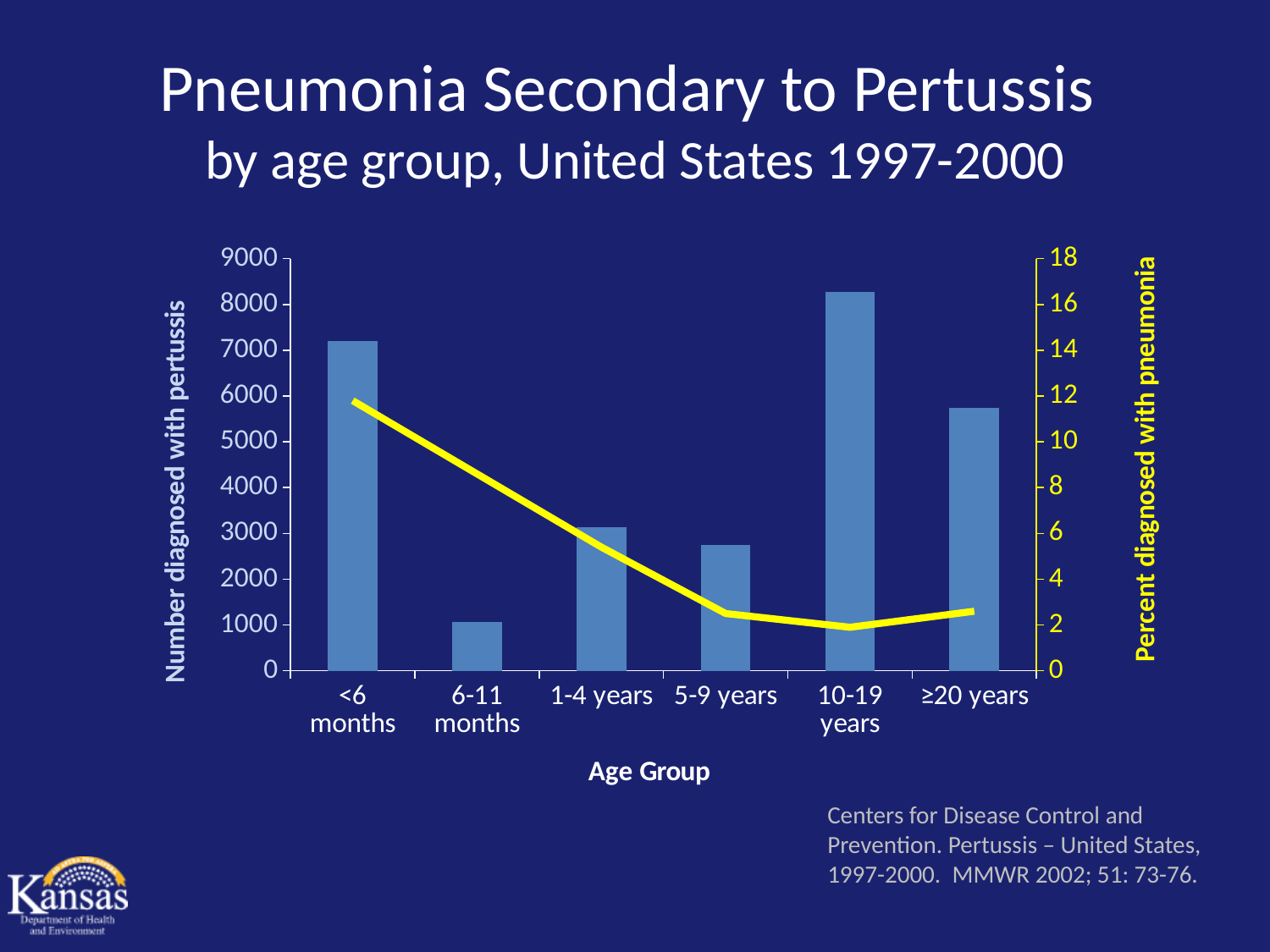
Which age group has the highest percent diagnosed with pneumonia? <6 months Which age group has the lowest number diagnosed with pertussis? 6-11 months Is the number diagnosed with pertussis for 6-11 months greater or less than 2000? less Which age group has the highest number diagnosed with pertussis? 10-19 years Is the number diagnosed with pertussis for <6 months greater or less than 6000? greater What kind of chart is shown on the slide? A bar chart with a line overlaid What is the title of the x axis? Age Group Which has a larger number diagnosed with pertussis, 1-4 years or 5-9 years? 1-4 years Does the percent diagnosed with pneumonia line rise or fall from <6 months to 5-9 years? fall Is the number diagnosed with pertussis for 10-19 years greater or less than 8000? greater How many age groups are shown on the x axis? 6